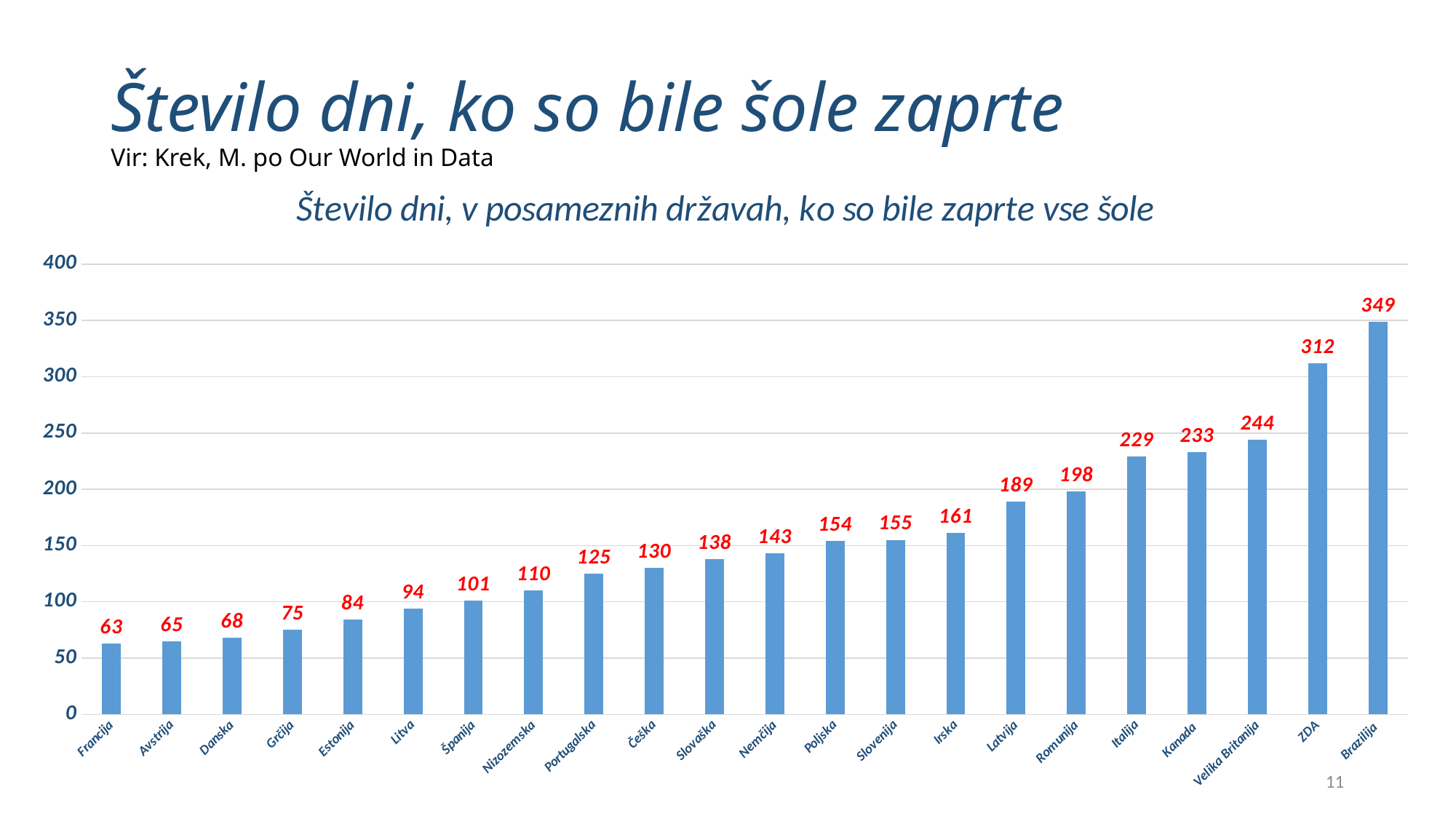
Which country has the lowest value? Francija What is the value for Slovenija? 155 What is the value for Velika Britanija? 244 Which is larger, the value for Latvija or the value for Irska? Latvija What kind of chart is this? bar chart Do the values rise or fall from left to right along the x axis? rise How many countries are shown on the chart? 22 What is the difference between the values for ZDA and Italija? 83 Is the value for Romunija greater or less than 150? greater What is the title of the chart? Število dni, v posameznih državah, ko so bile zaprte vse šole Which country has the highest value? Brazilija What is the value for Nemčija? 143